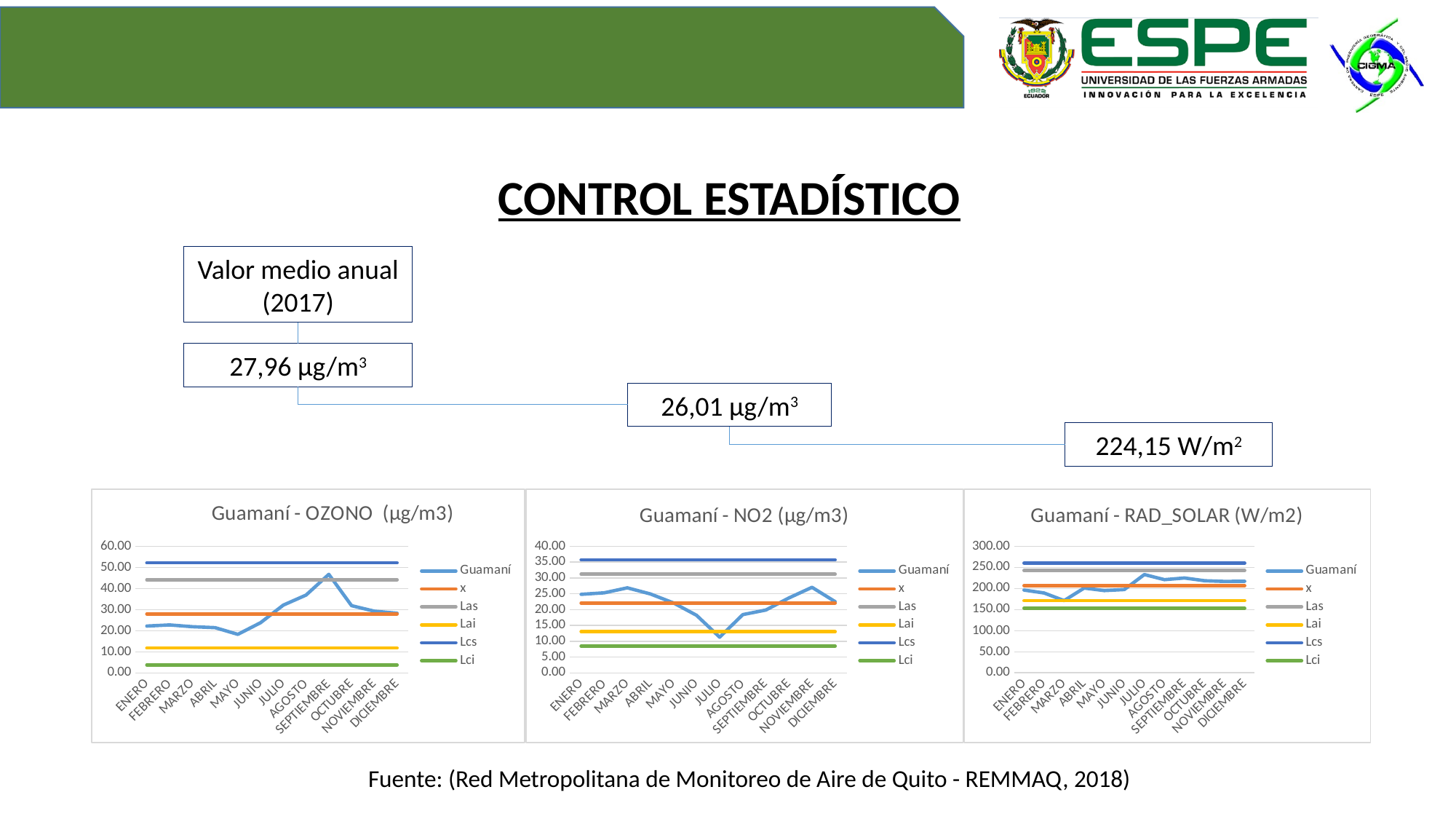
In the 'Guamaní - OZONO (µg/m3)' chart, in which month does the Guamaní series reach its highest value? SEPTIEMBRE In the 'Guamaní - OZONO (µg/m3)' chart, which is larger for the Guamaní series: SEPTIEMBRE or ENERO? SEPTIEMBRE What kind of chart is the 'Guamaní - OZONO (µg/m3)' chart? line chart In the 'Guamaní - RAD_SOLAR (W/m2)' chart, is the Guamaní value for JULIO greater or less than 200? greater In the 'Guamaní - NO2 (µg/m3)' chart, how many series does the legend list? 6 In the 'Guamaní - OZONO (µg/m3)' chart, does the Guamaní series rise or fall from MAYO to SEPTIEMBRE? rise In the 'Guamaní - OZONO (µg/m3)' chart, is the Guamaní value for SEPTIEMBRE greater or less than 40? greater In the 'Guamaní - NO2 (µg/m3)' chart, is the Guamaní value for JULIO greater or less than 15? less In the 'Guamaní - RAD_SOLAR (W/m2)' chart, in which month does the Guamaní series reach its highest value? JULIO In the 'Guamaní - NO2 (µg/m3)' chart, in which month does the Guamaní series reach its lowest value? JULIO In the 'Guamaní - OZONO (µg/m3)' chart, how many months are shown on the x axis? 12 In the 'Guamaní - OZONO (µg/m3)' chart, in which month does the Guamaní series reach its lowest value? MAYO